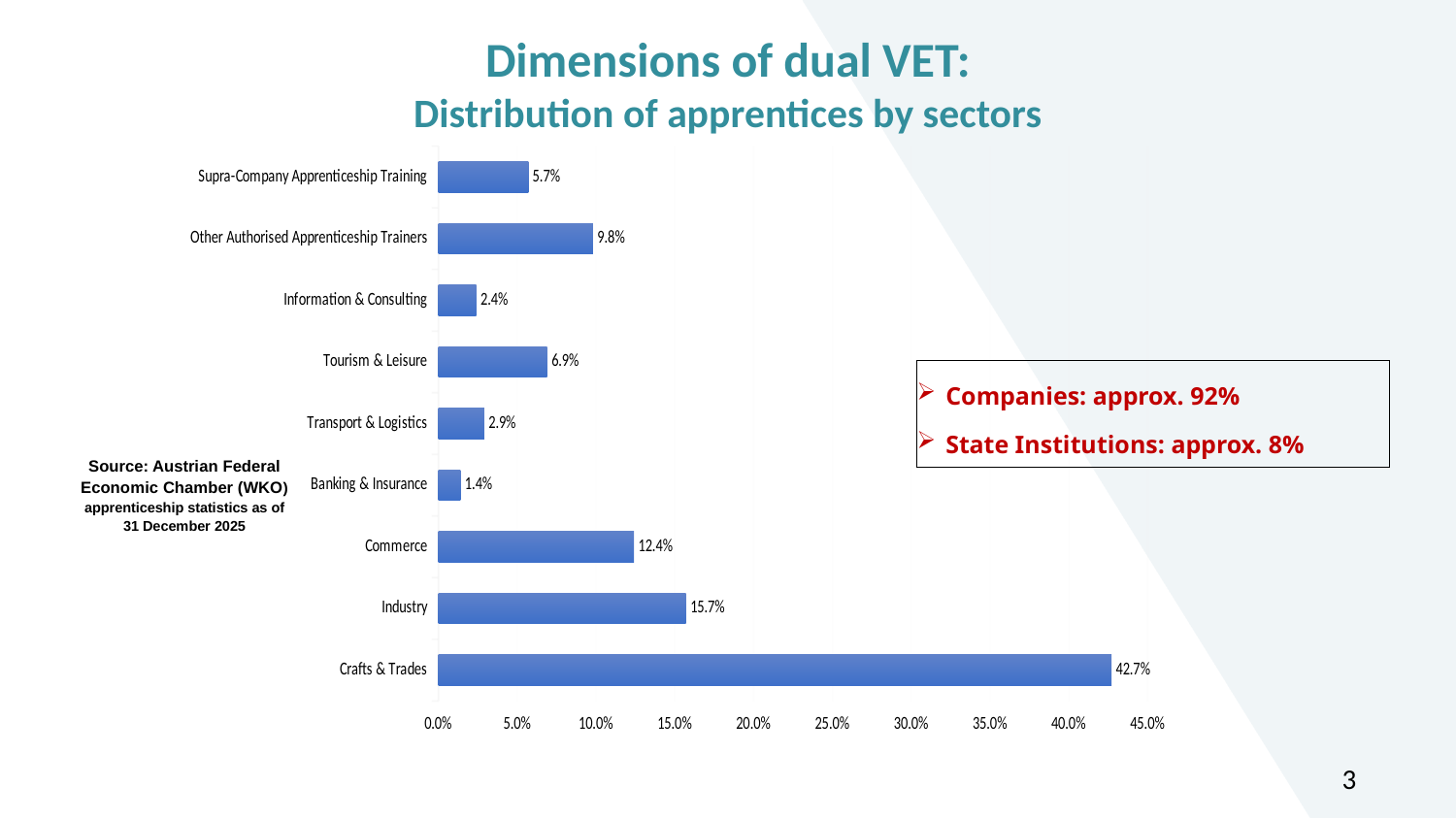
What is the value for Other Authorised Apprenticeship Trainers? 9.8% How many sectors are shown in the chart? 9 What is the value for Crafts & Trades? 42.7% Is the value for Crafts & Trades greater or less than 40.0%? greater What is the value for Industry? 15.7% Which is larger, the value for Tourism & Leisure or the value for Supra-Company Apprenticeship Training? Tourism & Leisure What is the value for Banking & Insurance? 1.4% What kind of chart is shown on the slide? bar chart Which sector has the lowest share of apprentices? Banking & Insurance What is the difference between the values for Industry and Commerce? 3.3% Which sector has the highest share of apprentices? Crafts & Trades What is the title of the chart on the slide? Distribution of apprentices by sectors